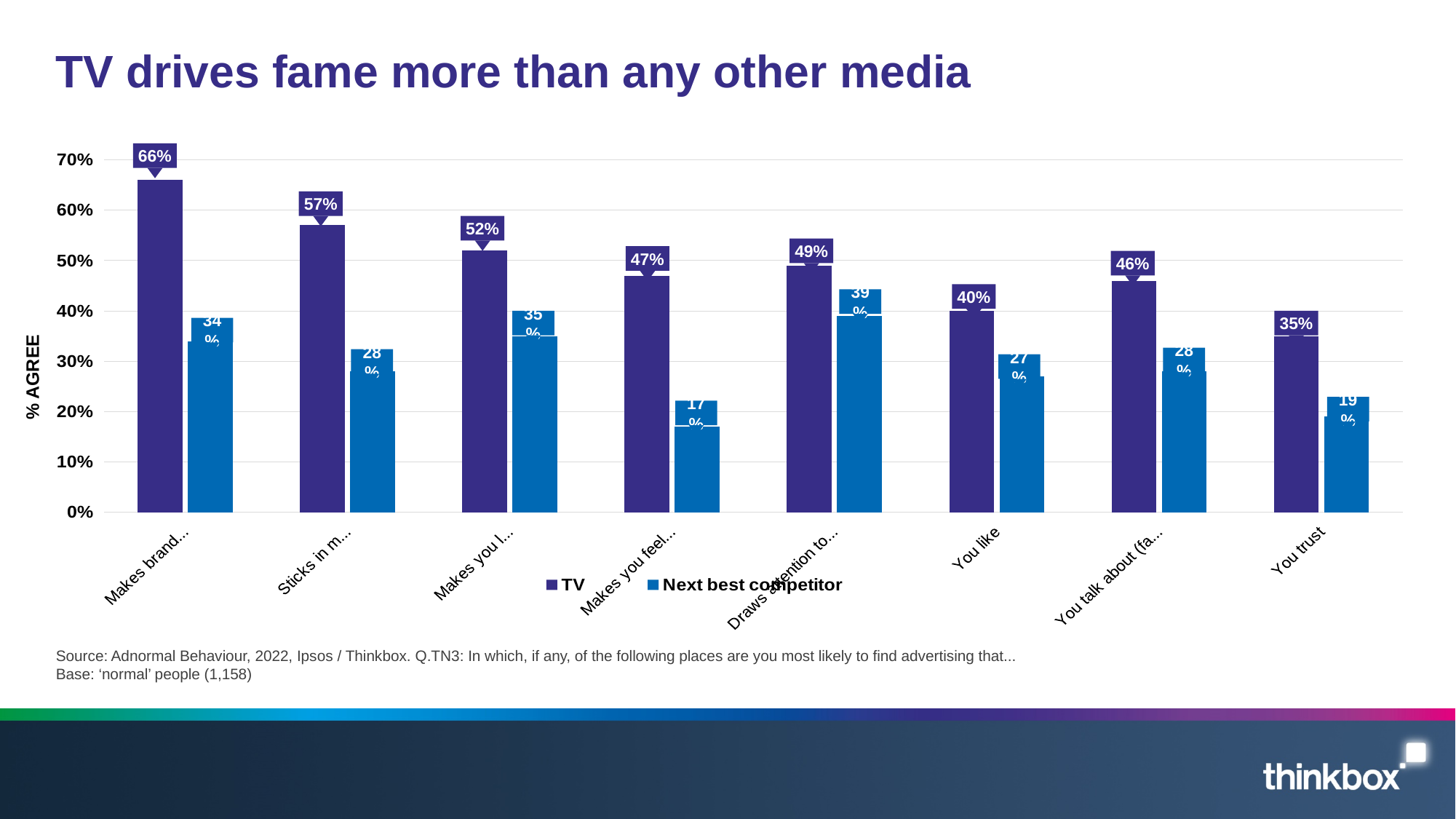
Which category has the lowest TV value? You trust Is the Next best competitor value for 'You like' greater or less than 30%? less What are the two series named in the legend? TV and Next best competitor For the category 'You like', what is the difference between the TV value and the Next best competitor value? 13 percentage points What is the TV value for the category 'You like'? 40% What is the Next best competitor value for the category 'You trust'? 19% What kind of chart is shown on the slide? Bar chart What is the TV value for the category 'You trust'? 35% How many categories are plotted along the x axis? 8 How many series does the legend list? 2 What is the highest TV value shown on the chart? 66% For the category 'You trust', which series has the larger value, TV or Next best competitor? TV